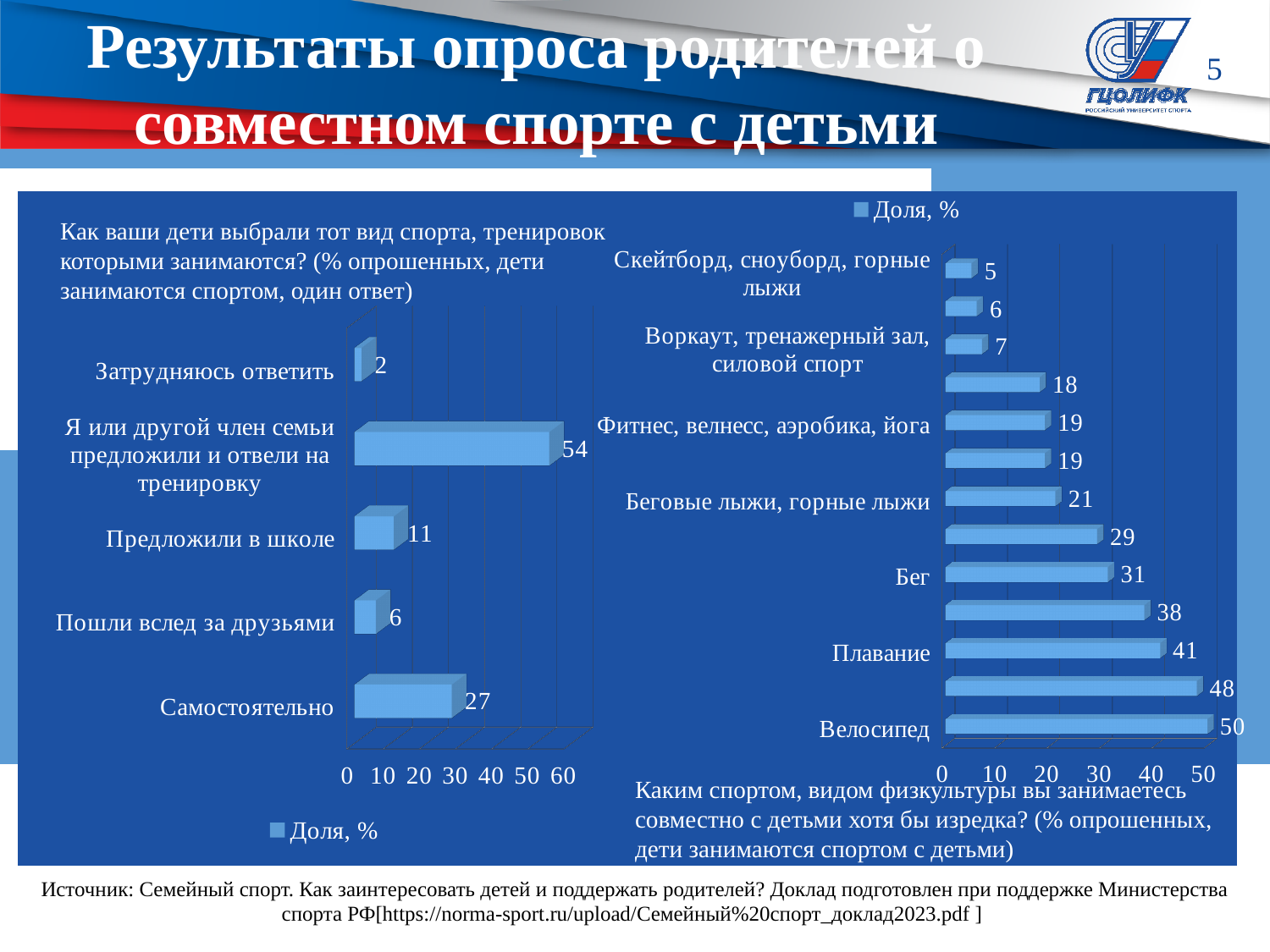
On the left chart (Как ваши дети выбрали тот вид спорта), what is the value for 'Самостоятельно'? 27 On the right chart (Каким спортом вы занимаетесь совместно с детьми), which is larger: 'Фитнес, велнесс, аэробика, йога' or 'Беговые лыжи, горные лыжи'? Беговые лыжи, горные лыжи On the right chart (Каким спортом вы занимаетесь совместно с детьми), what is the difference between 'Велосипед' and 'Скейтборд, сноуборд, горные лыжи'? 45 What type of chart is the right chart (Каким спортом вы занимаетесь совместно с детьми)? Bar chart What series name does the legend of the left chart show? Доля, % On the left chart (Как ваши дети выбрали тот вид спорта), which category has the highest value? Я или другой член семьи предложили и отвели на тренировку On the left chart (Как ваши дети выбрали тот вид спорта), how many categories are shown? 5 On the left chart (Как ваши дети выбрали тот вид спорта), which category has the lowest value? Затрудняюсь ответить On the right chart (Каким спортом вы занимаетесь совместно с детьми), what is the value for 'Плавание'? 41 On the left chart (Как ваши дети выбрали тот вид спорта), what is the difference between 'Предложили в школе' and 'Пошли вслед за друзьями'? 5 On the right chart (Каким спортом вы занимаетесь совместно с детьми), what is the value for 'Бег'? 31 On the right chart (Каким спортом вы занимаетесь совместно с детьми), what is the value for 'Велосипед'? 50